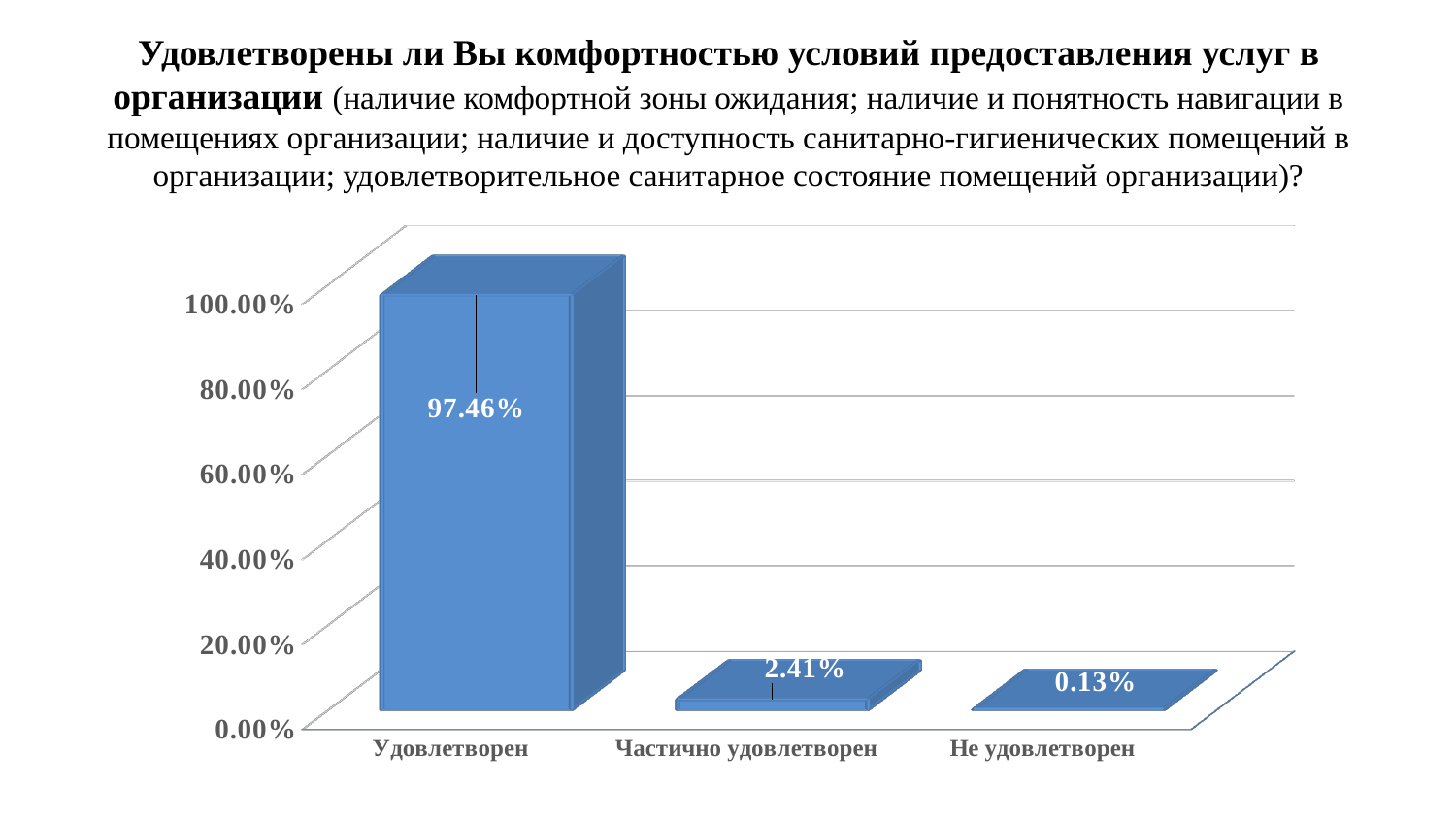
How many categories are shown on the x axis? 3 Do the values rise or fall from left to right along the x axis? fall What is the value for Не удовлетворен? 0.13% Which category has the lowest value? Не удовлетворен What is the value for Удовлетворен? 97.46% What is the value for Частично удовлетворен? 2.41% Which category has the highest value? Удовлетворен What is the difference between the values for Частично удовлетворен and Не удовлетворен? 2.28% Is the value for Удовлетворен greater or less than 80.00%? greater What kind of chart is shown on the slide? bar chart What is the difference between the values for Удовлетворен and Частично удовлетворен? 95.05% Which is larger, the value for Частично удовлетворен or the value for Не удовлетворен? Частично удовлетворен